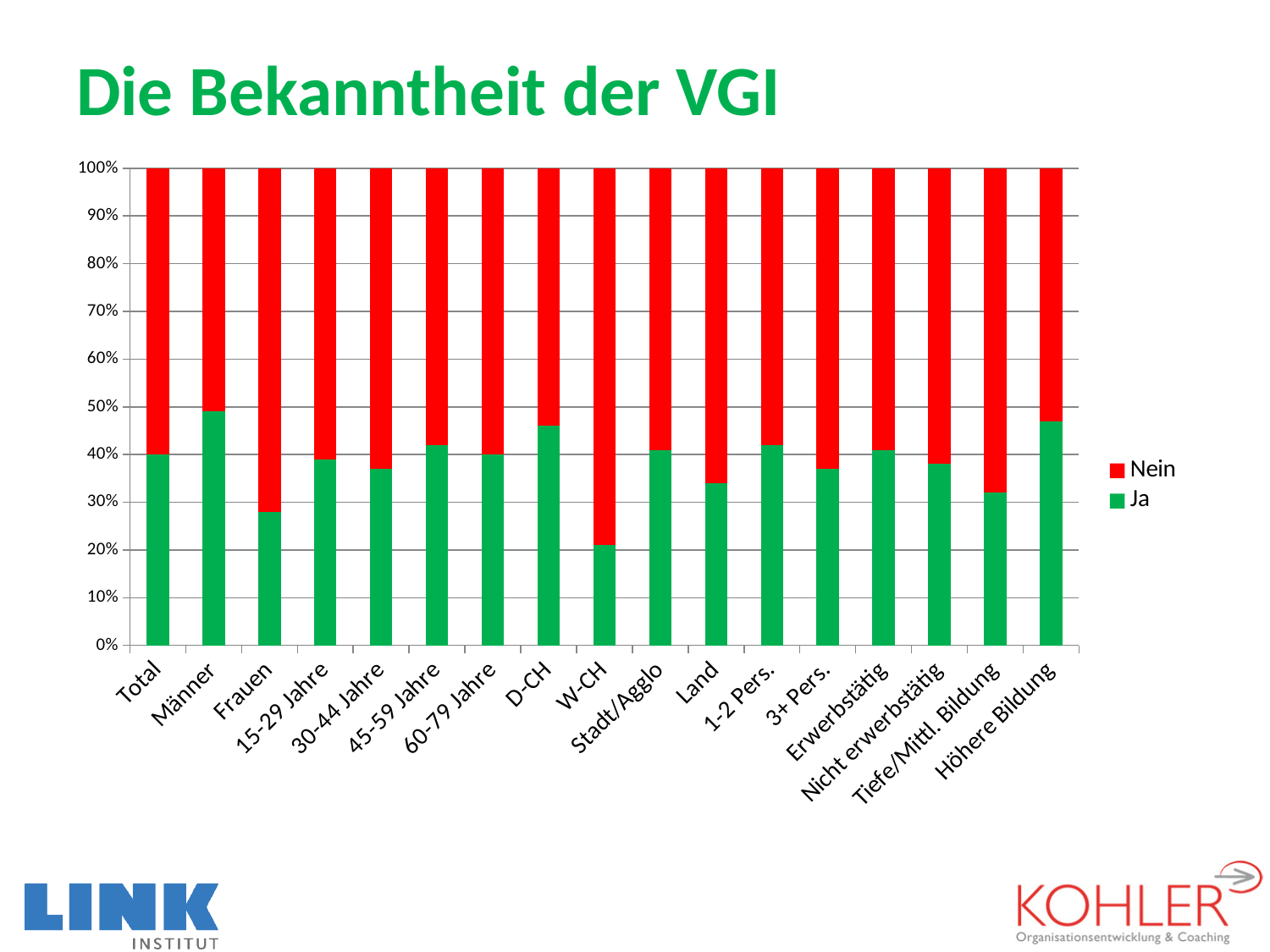
Which has the larger 'Ja' share, D-CH or W-CH? D-CH Which category has the highest 'Nein' share? W-CH How many categories are shown along the x axis? 17 Is the 'Ja' value for Land greater or less than 40%? less Which category has the lowest 'Ja' share? W-CH What is the title of the chart on the slide? Die Bekanntheit der VGI Is the 'Ja' value for W-CH greater or less than 30%? less What kind of chart is shown on the slide? stacked bar chart Which has the larger 'Ja' share, Männer or Frauen? Männer Is the 'Ja' value for Frauen greater or less than 30%? less How many series does the legend list? 2